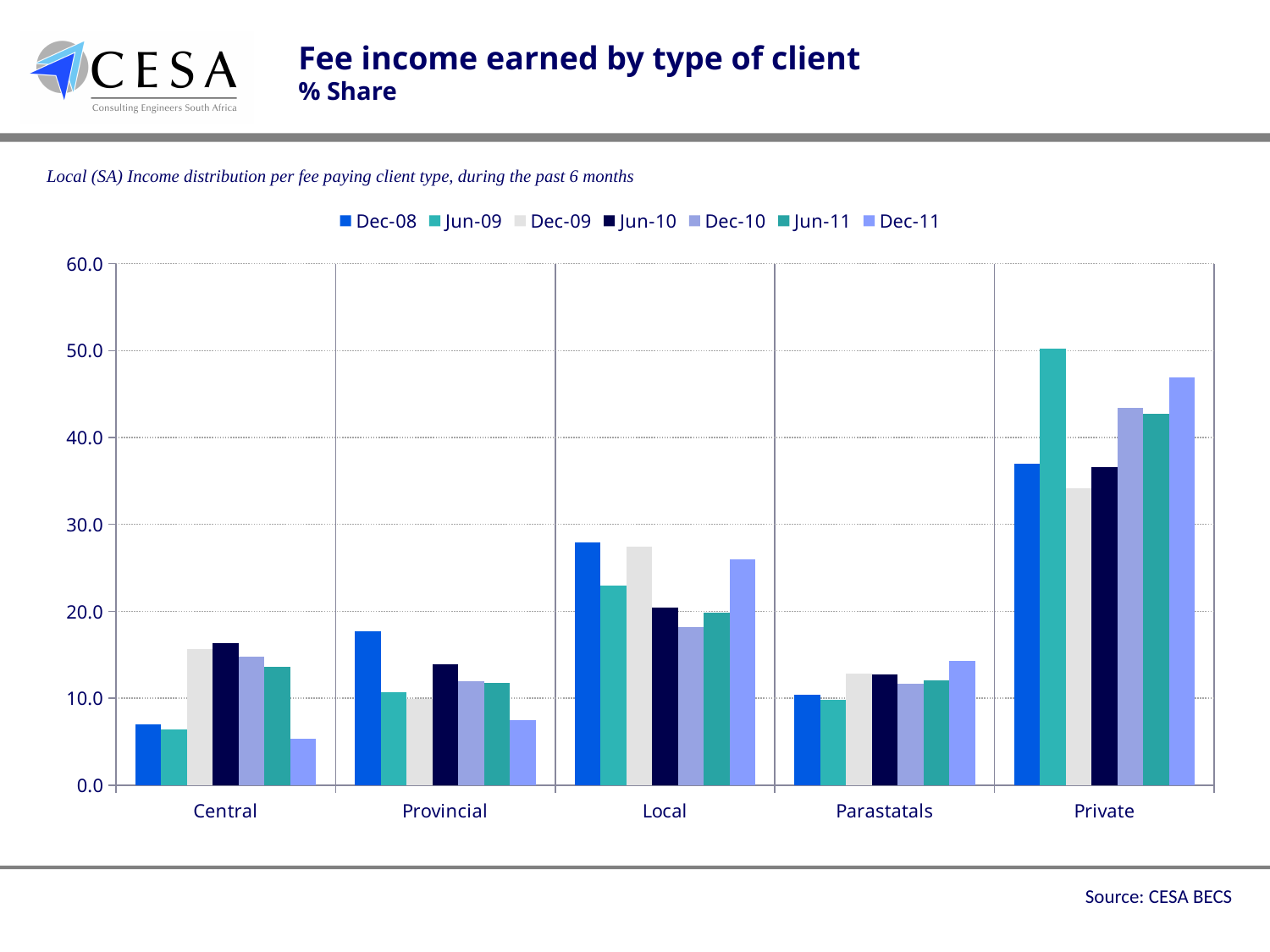
Which client type has the highest fee income share for Jun-09? Private How many series does the legend list? 7 Which series has the highest value for Private? Jun-09 How many client type categories are shown on the x axis? 5 Is the Jun-09 value for Private greater or less than 40.0? greater Which series has the lowest value for Central? Dec-11 For Provincial, which is larger: the Dec-08 value or the Dec-11 value? Dec-08 Is the Dec-08 value for Local greater or less than 20.0? greater Is the Dec-11 value for Parastatals greater or less than 20.0? less What kind of chart is shown on the slide? bar chart What is the source cited for the chart? CESA BECS